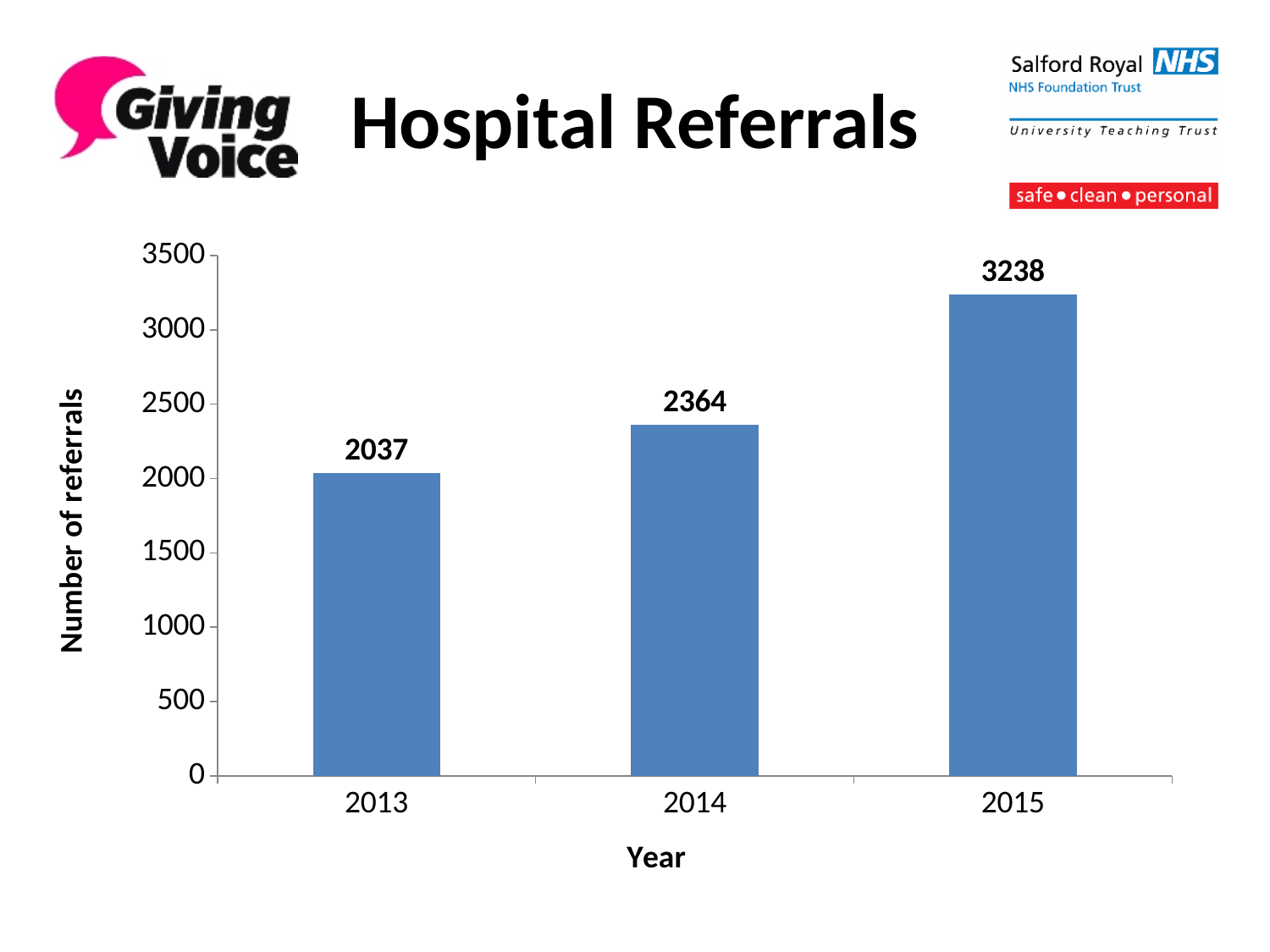
What kind of chart is shown on the slide? Bar chart Do the number of referrals rise or fall from 2013 to 2015? Rise What is the number of referrals for 2013? 2037 Which year had more referrals, 2013 or 2014? 2014 Which year has the lowest number of referrals? 2013 What is the number of referrals for 2015? 3238 What is the difference in referrals between 2015 and 2014? 874 Which year has the highest number of referrals? 2015 How many years are shown on the chart? 3 Is the value for 2015 greater or less than 3000? greater What is the difference in referrals between 2014 and 2013? 327 What is the number of referrals for 2014? 2364